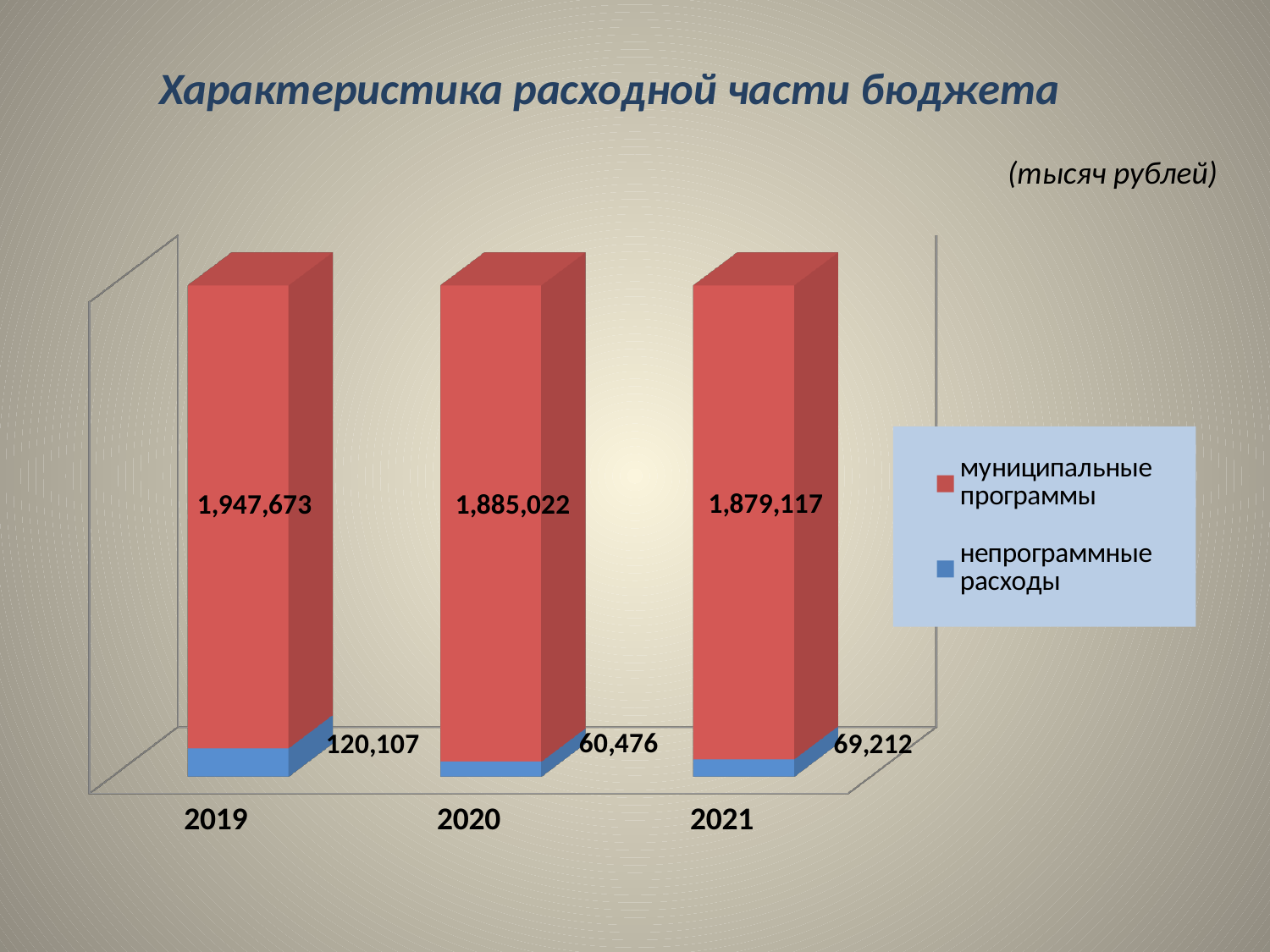
Which is larger: непрограммные расходы in 2020 or in 2021? 2021 In which year is the value for непрограммные расходы the highest? 2019 What is the difference between the непрограммные расходы values for 2021 and 2020? 8,736 What is the difference between the муниципальные программы values for 2019 and 2020? 62,651 How many series does the legend list? 2 How many years are shown on the x axis? 3 What is the value for непрограммные расходы in 2020? 60,476 What is the value for муниципальные программы in 2021? 1,879,117 What is the total of the stacked bar for 2019? 2,067,780 What kind of chart is shown on the slide? Stacked bar chart In which year is the value for муниципальные программы the lowest? 2021 What is the value for муниципальные программы in 2019? 1,947,673